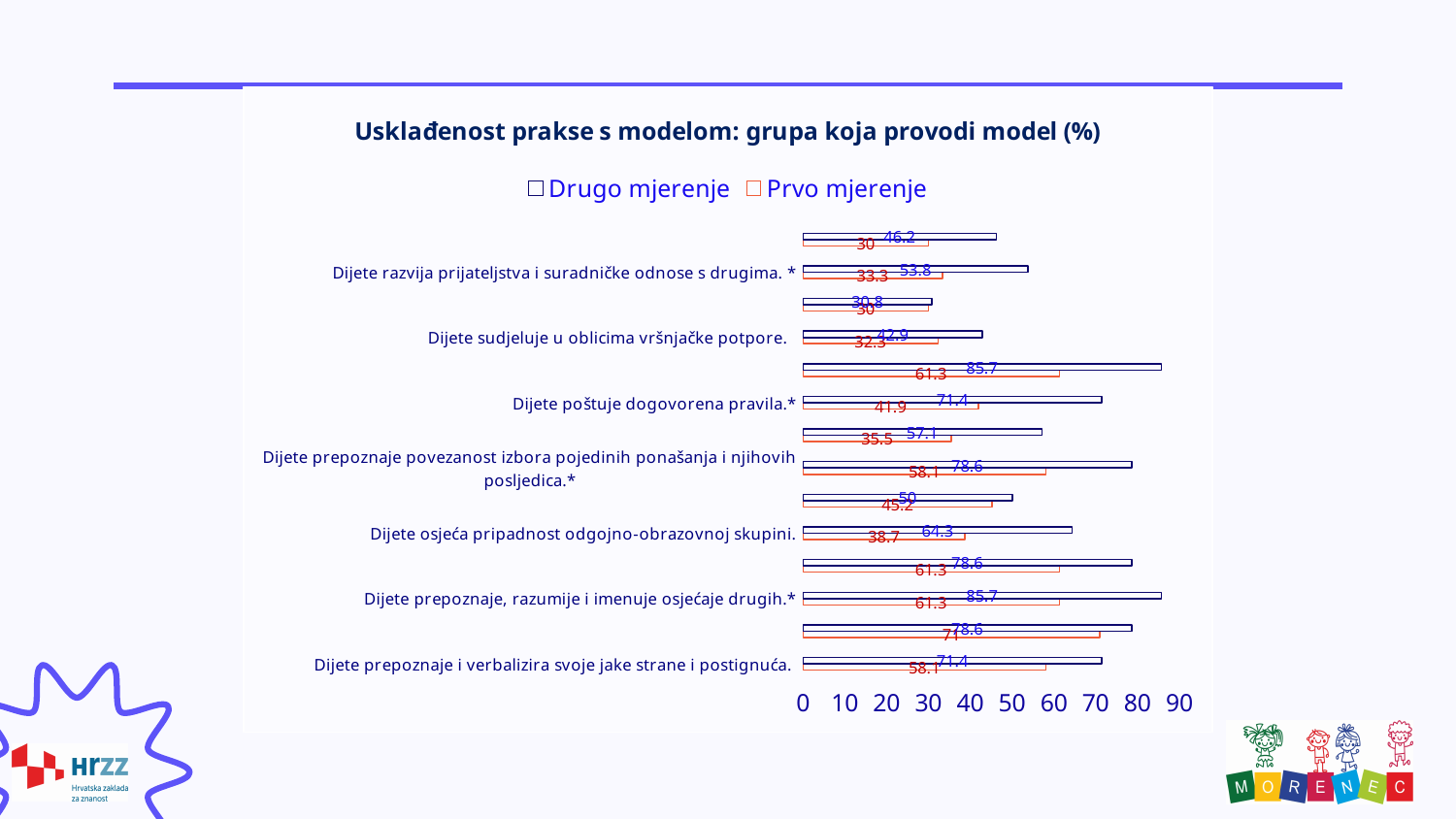
What is the Prvo mjerenje value for "Dijete prepoznaje, razumije i imenuje osjećaje drugih.*"? 61.3 What is the Prvo mjerenje value for "Dijete poštuje dogovorena pravila.*"? 41.9 How many series does the legend list? 2 What is the difference between the Drugo mjerenje and Prvo mjerenje values for "Dijete osjeća pripadnost odgojno-obrazovnoj skupini."? 25.6 What is the title of the chart? Usklađenost prakse s modelom: grupa koja provodi model (%) What is the Drugo mjerenje value for "Dijete osjeća pripadnost odgojno-obrazovnoj skupini."? 64.3 What kind of chart is shown on the slide? bar chart What is the difference between the Drugo mjerenje and Prvo mjerenje values for "Dijete poštuje dogovorena pravila.*"? 29.5 Is the Drugo mjerenje value for "Dijete prepoznaje, razumije i imenuje osjećaje drugih.*" greater or less than 80? greater What is the Drugo mjerenje value for "Dijete poštuje dogovorena pravila.*"? 71.4 What are the two series named in the legend? Drugo mjerenje and Prvo mjerenje For "Dijete sudjeluje u oblicima vršnjačke potpore.", which series has the larger value, Drugo mjerenje or Prvo mjerenje? Drugo mjerenje